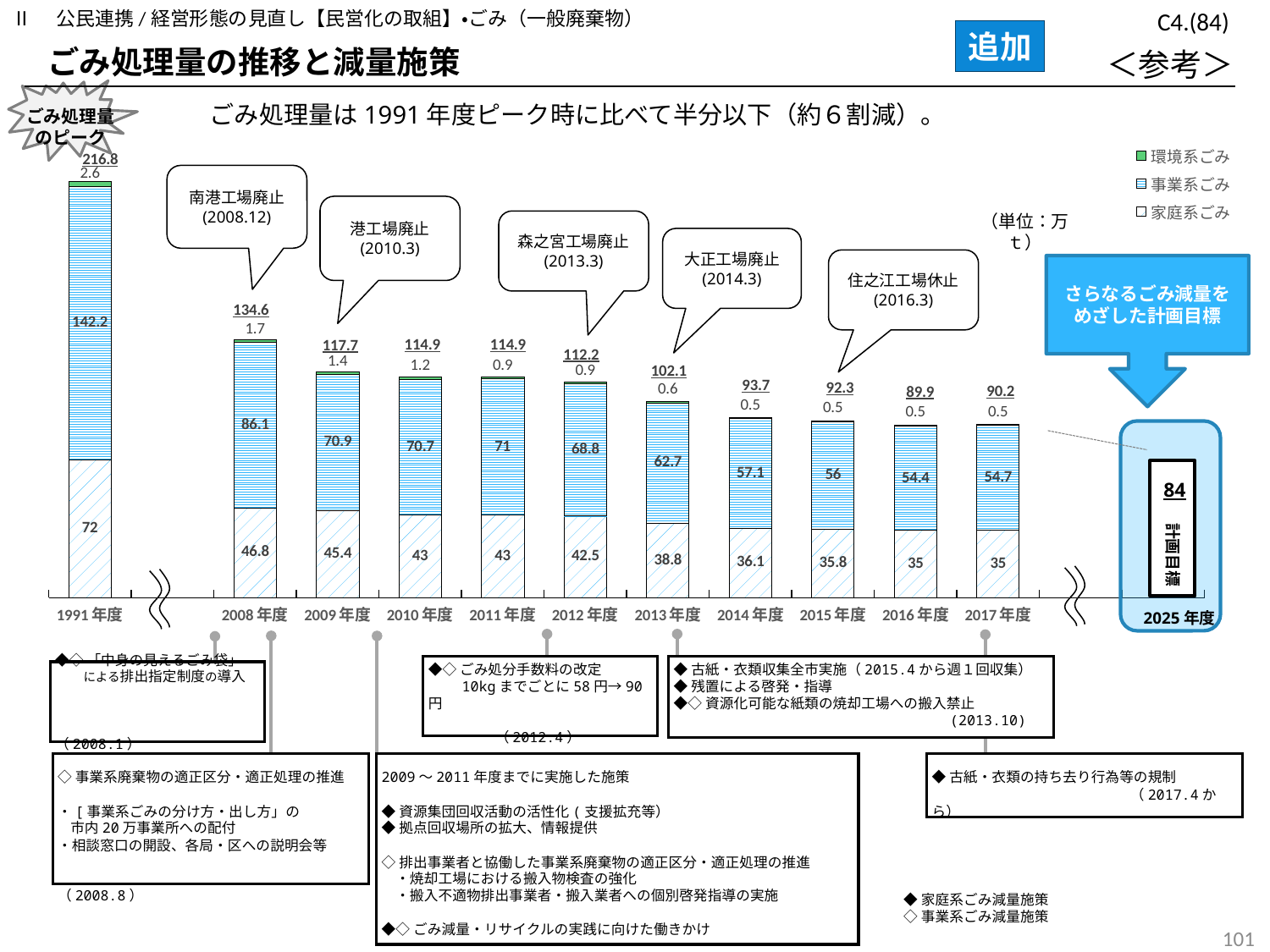
What is the difference between the total waste volume in 1991年度 and in 2017年度? 126.6 What is the value of 事業系ごみ for 2008年度? 86.1 How many series does the legend list? 3 What is the value of 家庭系ごみ for 2013年度? 38.8 What is the value of 環境系ごみ for 2009年度? 1.4 Which year has the highest total waste volume? 1991年度 Does the total waste volume generally rise or fall from 1991年度 to 2017年度? Fall Which is larger, the 事業系ごみ value for 2014年度 or for 2015年度? 2014年度 What kind of chart is used to show the waste volume by year? Stacked bar chart What is the total waste volume (ごみ処理量) shown for 1991年度? 216.8 What is the planned target (計画目標) value shown for 2025年度? 84 Which year between 2008年度 and 2017年度 has the lowest total waste volume? 2016年度